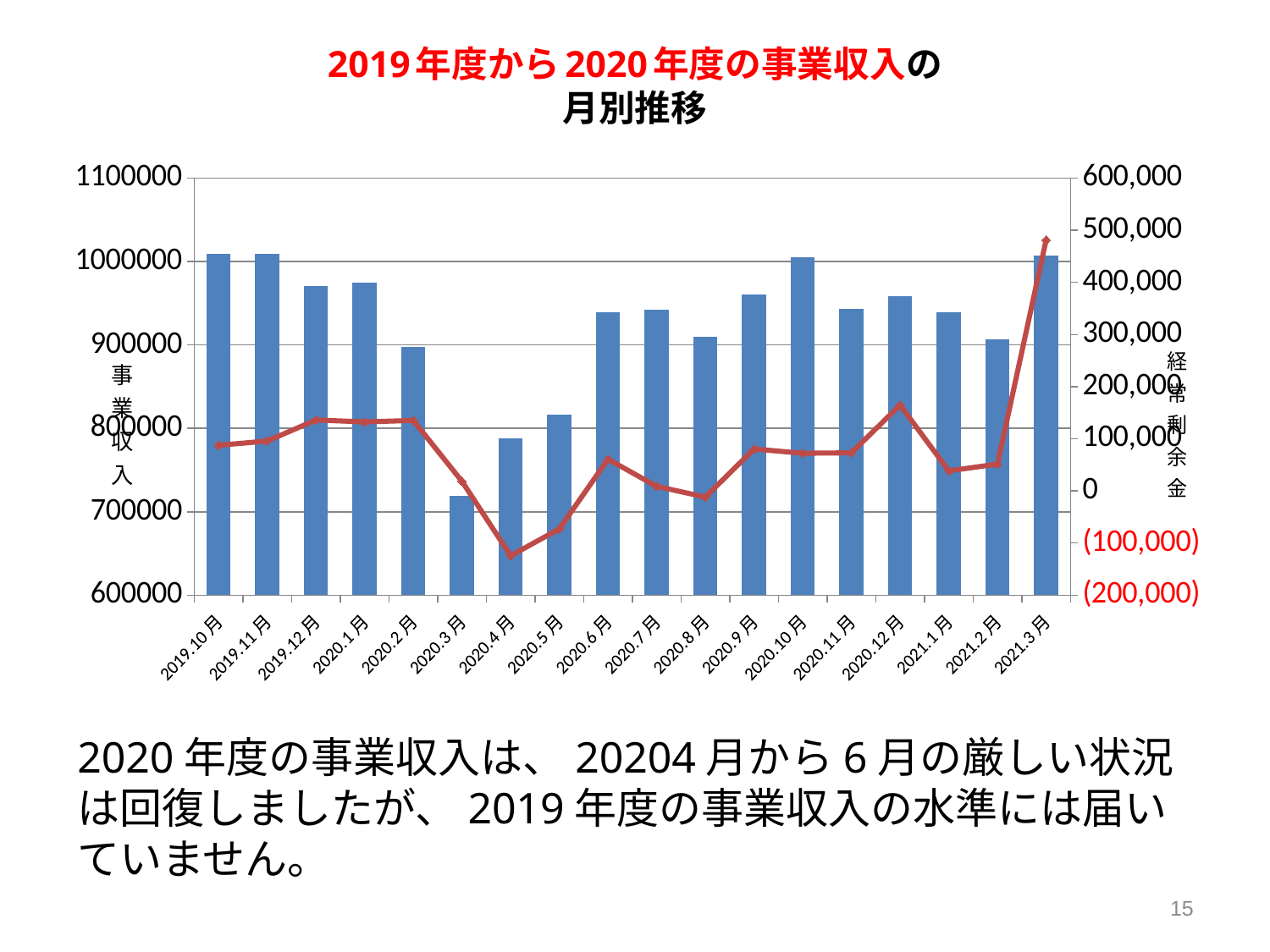
In which month does the 経常剰余金 line reach its highest point? 2021.3月 What kind of chart is shown on the slide? A combination bar and line chart Which month has the larger 事業収入 bar, 2020.3月 or 2020.6月? 2020.6月 What is the label on the right-hand vertical axis? 経常剰余金 Do the 事業収入 bars rise or fall overall from 2019.10月 to 2020.3月? fall In which month does the 経常剰余金 line reach its lowest point? 2020.4月 Is the 事業収入 bar for 2019.10月 greater or less than 900000? greater Is the 事業収入 bar for 2020.3月 greater or less than 800000? less Which month has the lowest bar for 事業収入? 2020.3月 Is the 経常剰余金 value for 2021.3月 greater or less than 400,000? greater How many months (categories) are plotted along the x axis? 18